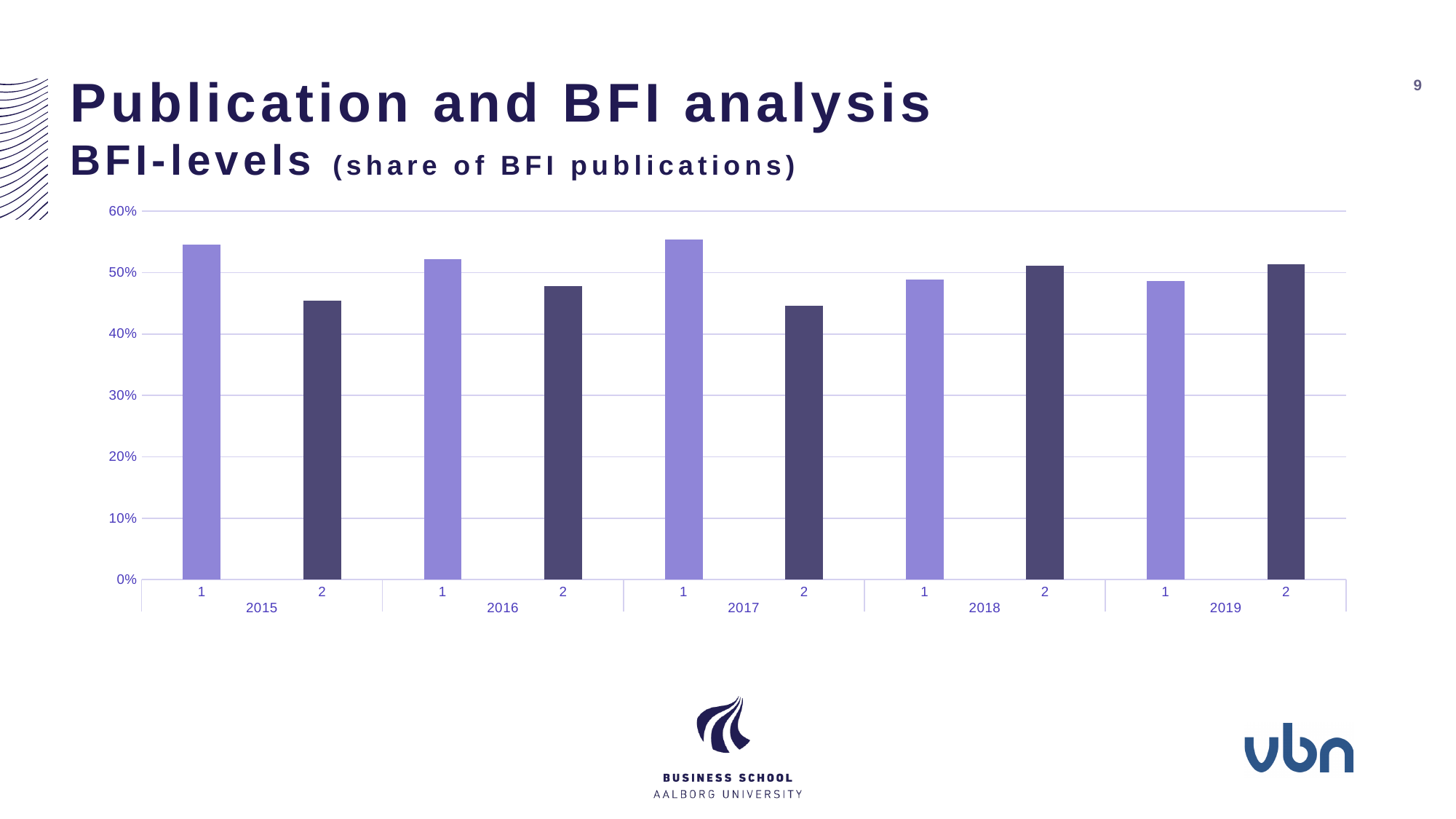
How many bars are plotted in the chart? 10 Is the value for BFI level 1 in 2017 greater or less than 50%? greater Is the value for BFI level 2 in 2015 greater or less than 50%? less How many years are shown along the x axis of the chart? 5 What is the subtitle of the chart shown on the slide? BFI-levels (share of BFI publications) Is the value for BFI level 1 in 2015 greater or less than 50%? greater What kind of chart is shown on the slide? bar chart In 2017, which is larger: the bar for level 1 or the bar for level 2? level 1 In 2015, which is larger: the bar for level 1 or the bar for level 2? level 1 What is the highest value shown on the y axis of the chart? 60%